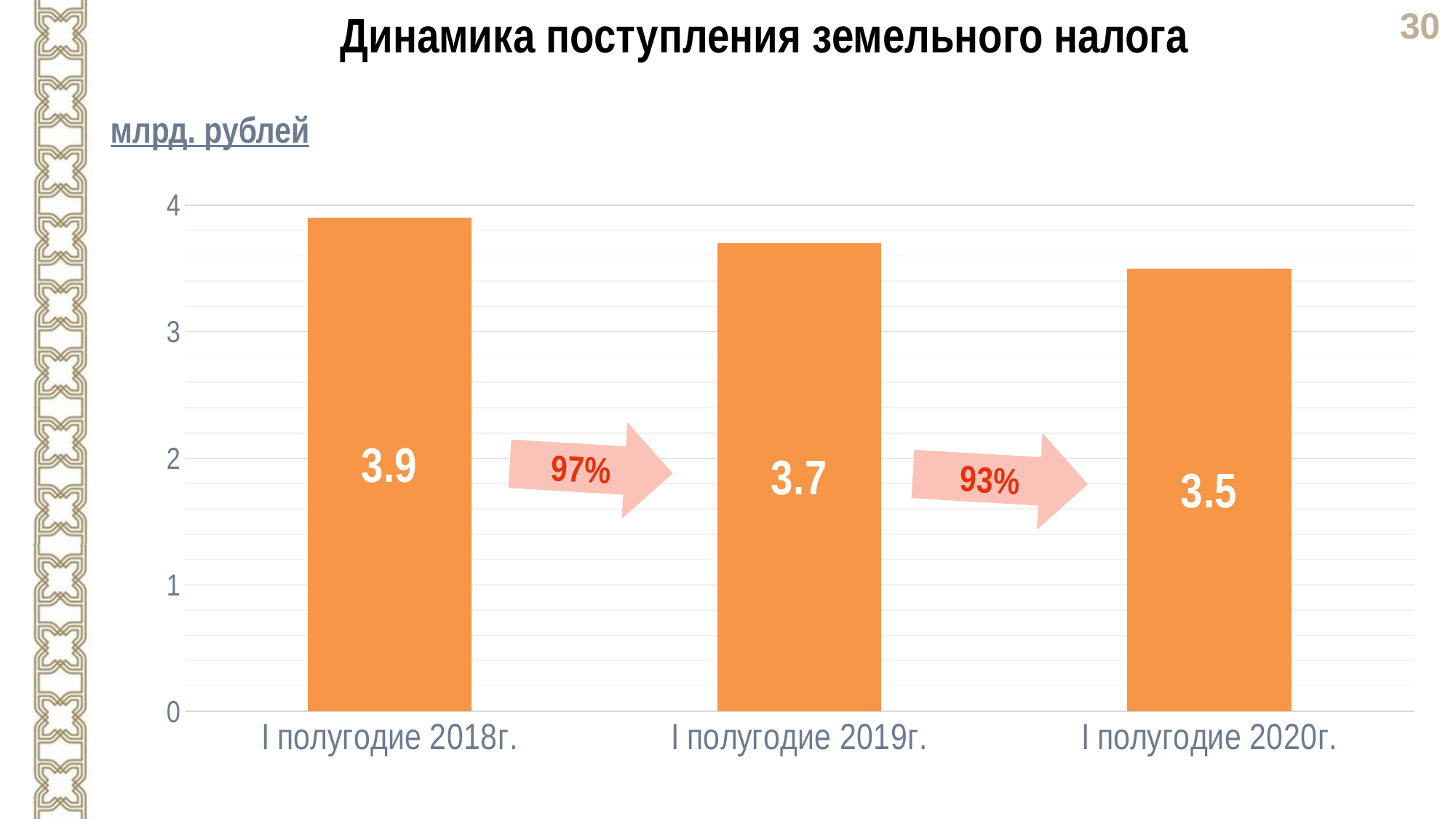
Is the value for I полугодие 2020г. greater or less than 3? greater Do the values rise or fall from I полугодие 2018г. to I полугодие 2020г.? fall What is the value for I полугодие 2018г.? 3.9 How many periods are shown on the chart? 3 Which period has the lowest value? I полугодие 2020г. What is the difference between the values for I полугодие 2018г. and I полугодие 2020г.? 0.4 What is the value for I полугодие 2019г.? 3.7 What is the value for I полугодие 2020г.? 3.5 Which is larger, the value for I полугодие 2019г. or I полугодие 2020г.? I полугодие 2019г. What is the title of the chart? Динамика поступления земельного налога Which period has the highest value? I полугодие 2018г. What kind of chart is this? bar chart